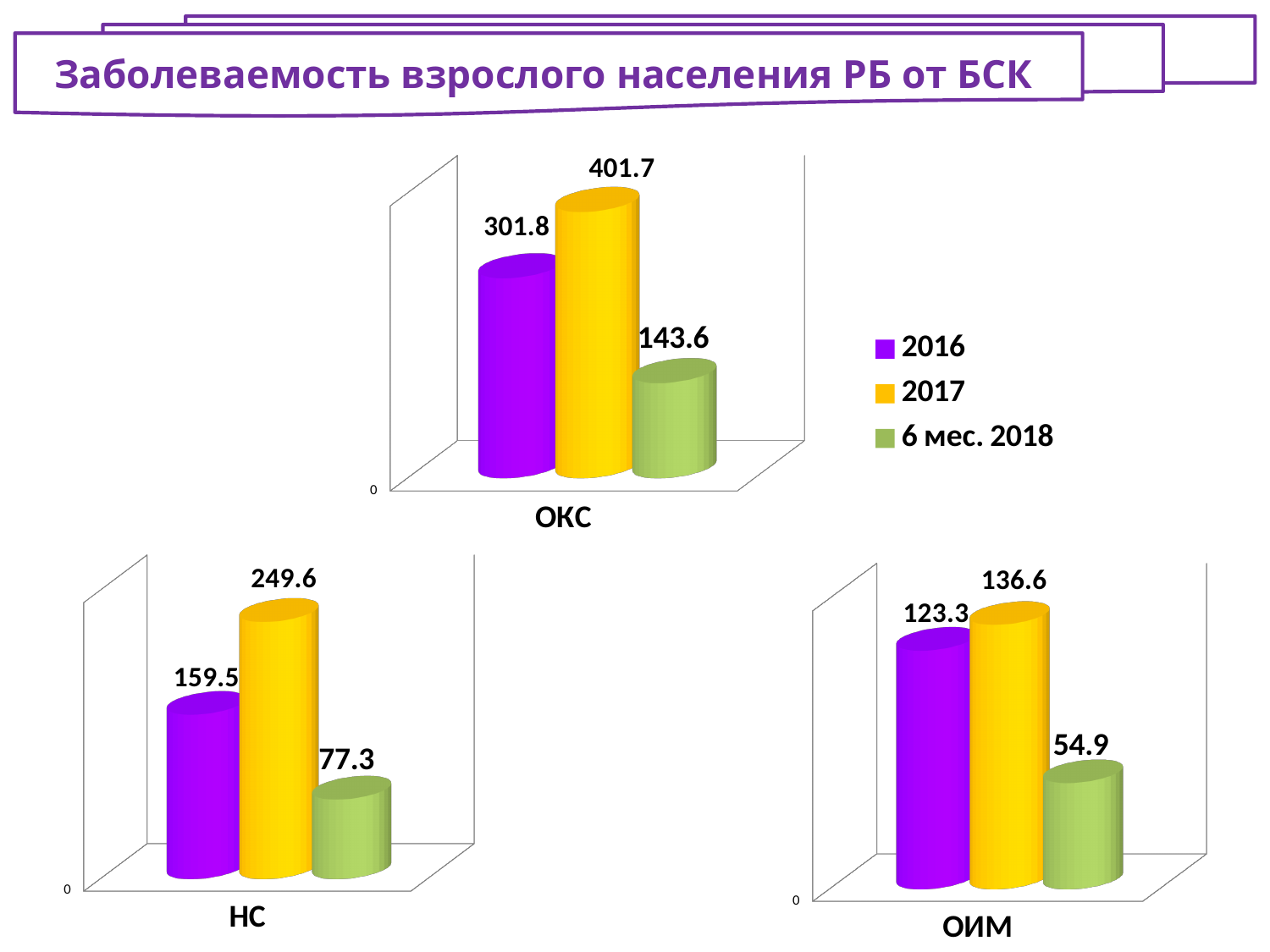
What kind of chart is the ОИМ chart? bar chart How many series does the legend list? 3 In the ОКС chart, which series has the highest value? 2017 In the ОКС chart, what is the difference between the 2016 value and the 6 мес. 2018 value? 158.2 Which colour represents 2017 in the legend? yellow How many charts are shown on the slide? 3 In the НС chart, what is the value for 2016? 159.5 In the НС chart, which is larger, the value for 2017 or the value for 2016? 2017 In the ОИМ chart, what is the difference between the 2017 value and the 2016 value? 13.3 In the НС chart, which series has the lowest value? 6 мес. 2018 In the ОКС chart, what is the value for 2017? 401.7 In the ОИМ chart, what is the value for 6 мес. 2018? 54.9